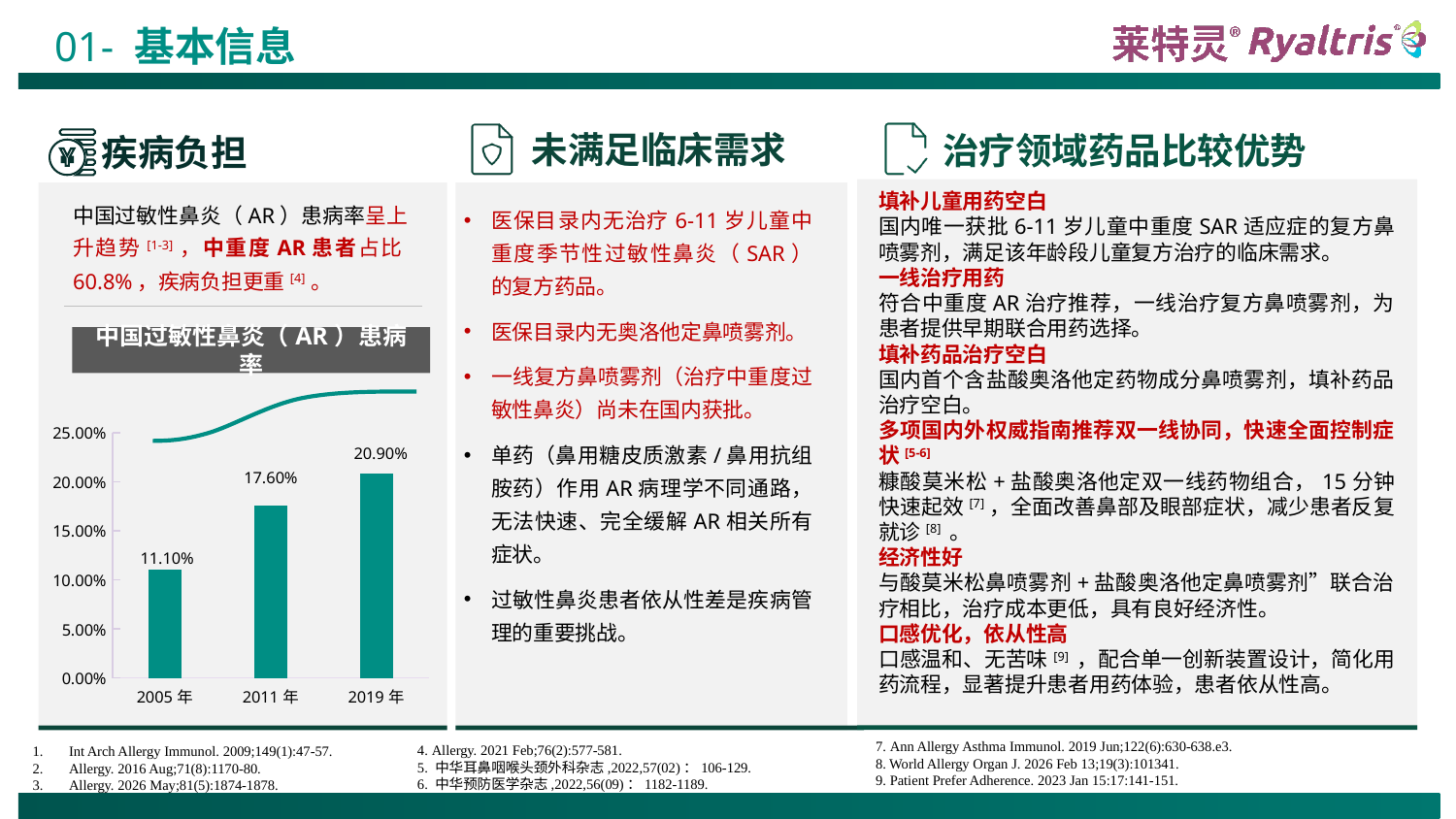
What is the difference between the values for 2019 年 and 2005 年? 9.80% What kind of chart is shown on the slide? bar chart What is the value for 2019 年 in the chart? 20.90% What is the difference between the values for 2011 年 and 2005 年? 6.50% Which year has the lowest value in the chart? 2005 年 What is the value for 2011 年 in the chart? 17.60% Is the value for 2011 年 greater or less than 15.00%? greater What is the value for 2005 年 in the chart? 11.10% Do the values in the chart rise or fall from 2005 年 to 2019 年? rise Which is larger, the value for 2011 年 or the value for 2019 年? 2019 年 Which year has the highest value in the chart? 2019 年 How many years are shown on the x axis of the chart? 3